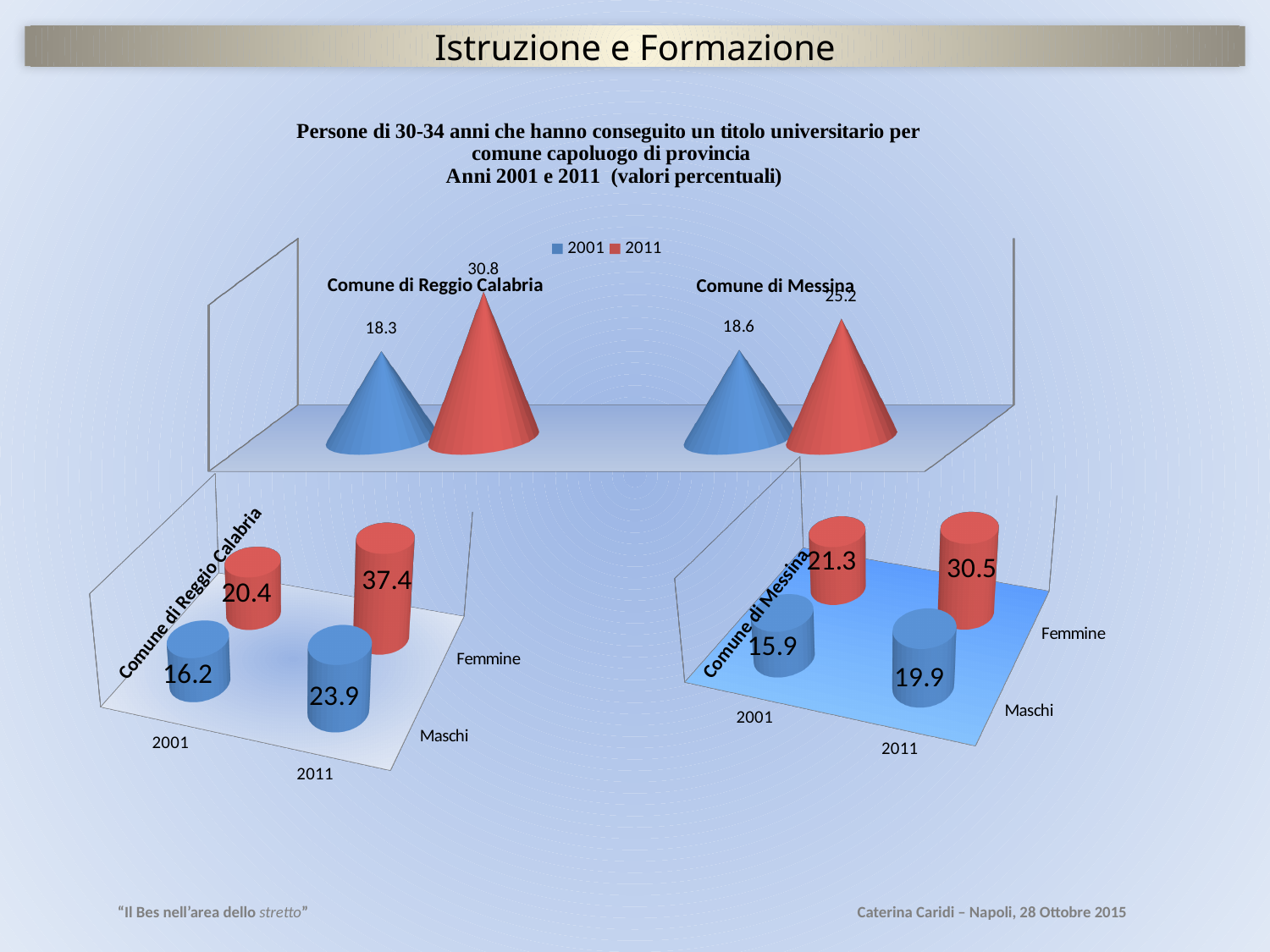
In the top chart, what is the difference between the 2011 and 2001 values for Comune di Reggio Calabria? 12.5 In the bottom-left chart (Comune di Reggio Calabria), what is the value for Maschi in 2001? 16.2 In the bottom-right chart (Comune di Messina), which group and year has the highest value? Femmine 2011 In the top chart, what is the value for Comune di Reggio Calabria in 2011? 30.8 In the top chart, which comune has the higher value for 2011? Comune di Reggio Calabria How many series does the legend of the top chart list? 2 In the top chart, what is the value for Comune di Messina in 2001? 18.6 In the bottom-right chart (Comune di Messina), what is the difference between Femmine and Maschi in 2011? 10.6 In the bottom-right chart (Comune di Messina), what is the value for Femmine in 2001? 21.3 In the bottom-left chart (Comune di Reggio Calabria), what is the value for Femmine in 2011? 37.4 In the top chart, which colour represents the year 2011? Red In the bottom-left chart (Comune di Reggio Calabria), which group and year has the lowest value? Maschi 2001